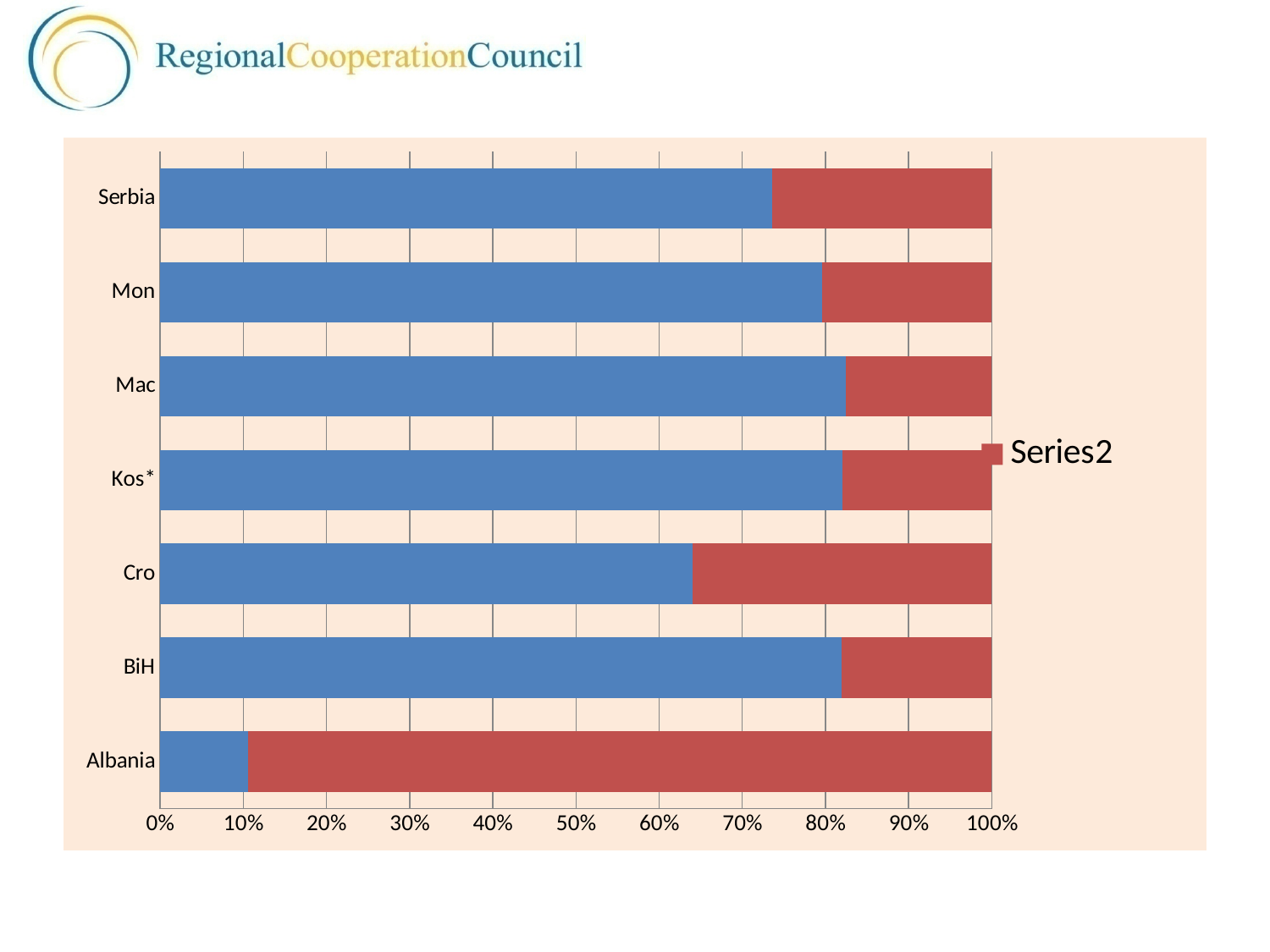
What is the name of the series shown in the chart's legend? Series2 Is the blue segment for Mac greater or less than 80%? greater What kind of chart is shown on the slide? stacked bar chart How many categories are shown on the vertical axis of the chart? 7 Which category has the largest red (Series2) segment? Albania Which has the larger blue segment, Serbia or Cro? Serbia How many series does the chart's legend list? 1 Is the blue segment for Albania greater or less than 20%? less What is the total of the stacked bar for Serbia? 100% Is the blue segment for Serbia greater or less than 80%? less Which category has the smallest blue segment? Albania